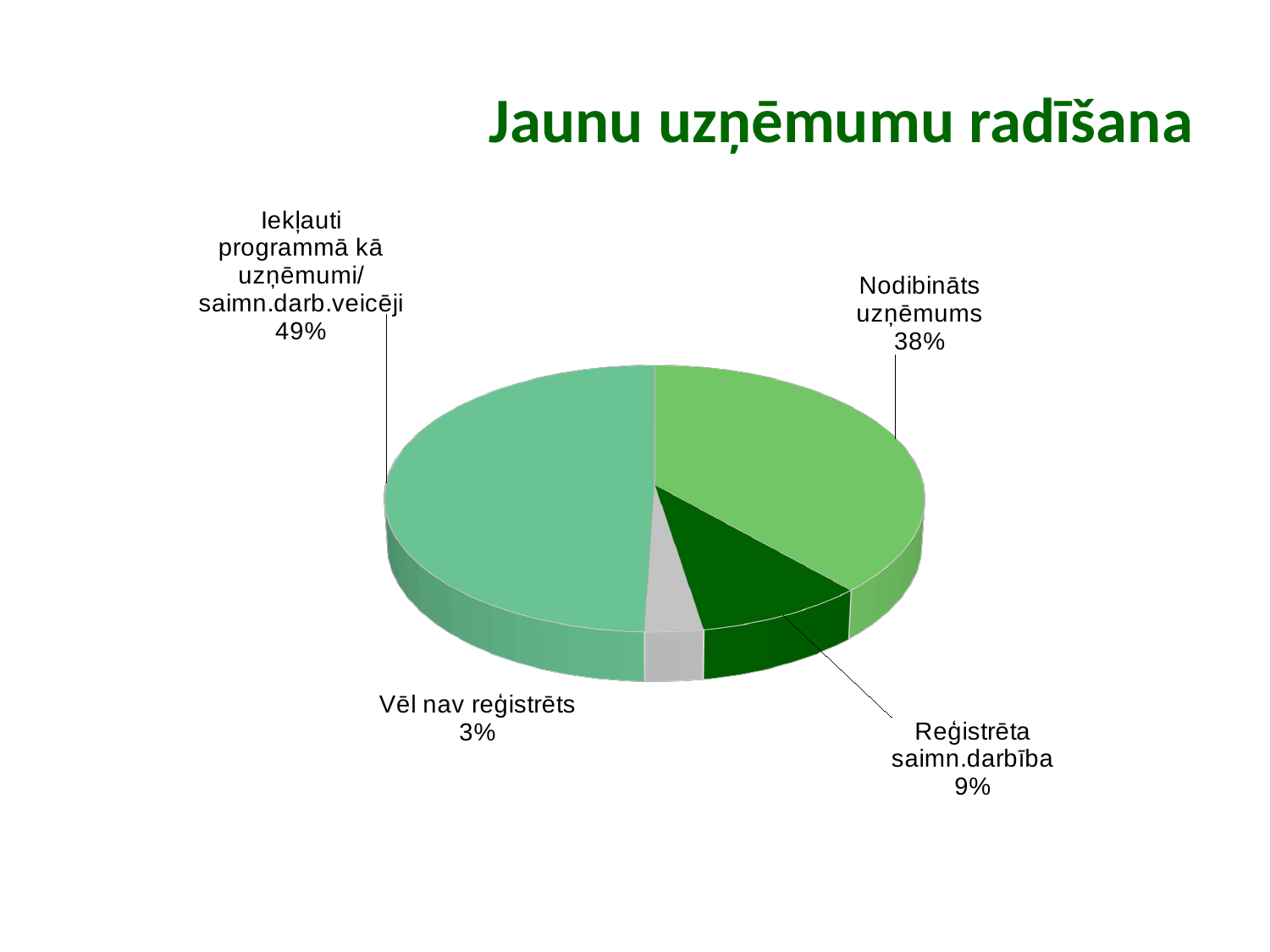
Which category has the smallest share of the pie? Vēl nav reģistrēts What share of the pie is labelled "Iekļauti programmā kā uzņēmumi/saimn.darb.veicēji"? 49% What colour is the slice for "Vēl nav reģistrēts"? grey Which category has the largest share of the pie? Iekļauti programmā kā uzņēmumi/saimn.darb.veicēji What is the difference in percentage points between "Iekļauti programmā kā uzņēmumi/saimn.darb.veicēji" and "Nodibināts uzņēmums"? 11 percentage points What share of the pie is labelled "Nodibināts uzņēmums"? 38% Which is larger: the share for "Reģistrēta saimn.darbība" or the share for "Vēl nav reģistrēts"? Reģistrēta saimn.darbība What kind of chart is shown on the slide? pie chart What is the title of the chart? Jaunu uzņēmumu radīšana What share of the pie is labelled "Reģistrēta saimn.darbība"? 9% How many slices does the pie chart have? 4